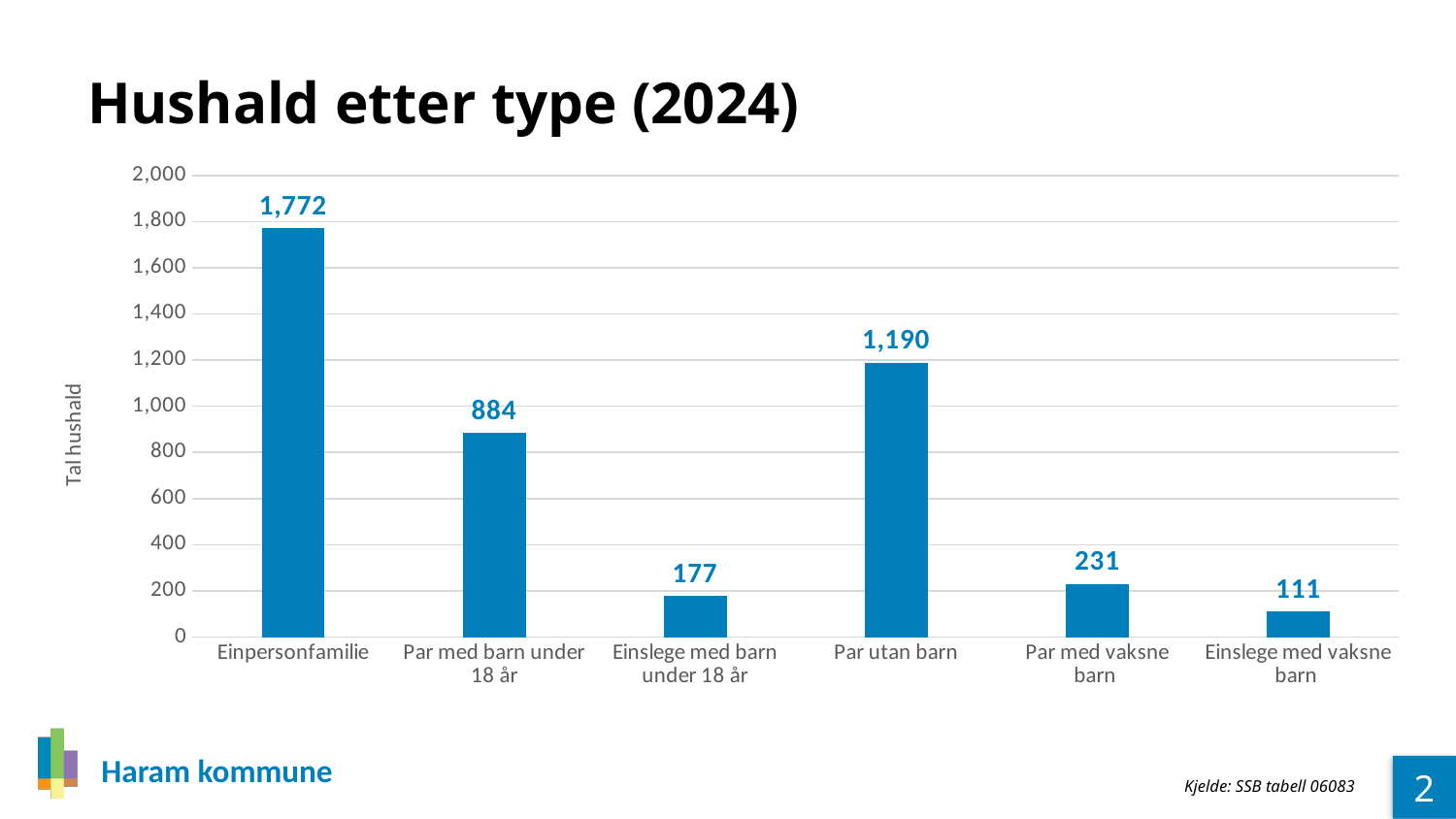
What kind of chart is shown on the slide? bar chart What is the difference between Einpersonfamilie and Par utan barn? 582 Is the value for Par med barn under 18 år greater or less than 1,000? less How many household types are shown on the chart? 6 Which is larger, Par med barn under 18 år or Par med vaksne barn? Par med barn under 18 år Which household type has the lowest value? Einslege med vaksne barn What is the value for Par utan barn? 1,190 What is the value for Einslege med vaksne barn? 111 Which household type has the highest value? Einpersonfamilie What is the title of the chart? Hushald etter type (2024) What is the value for Einslege med barn under 18 år? 177 What is the value for Einpersonfamilie? 1,772